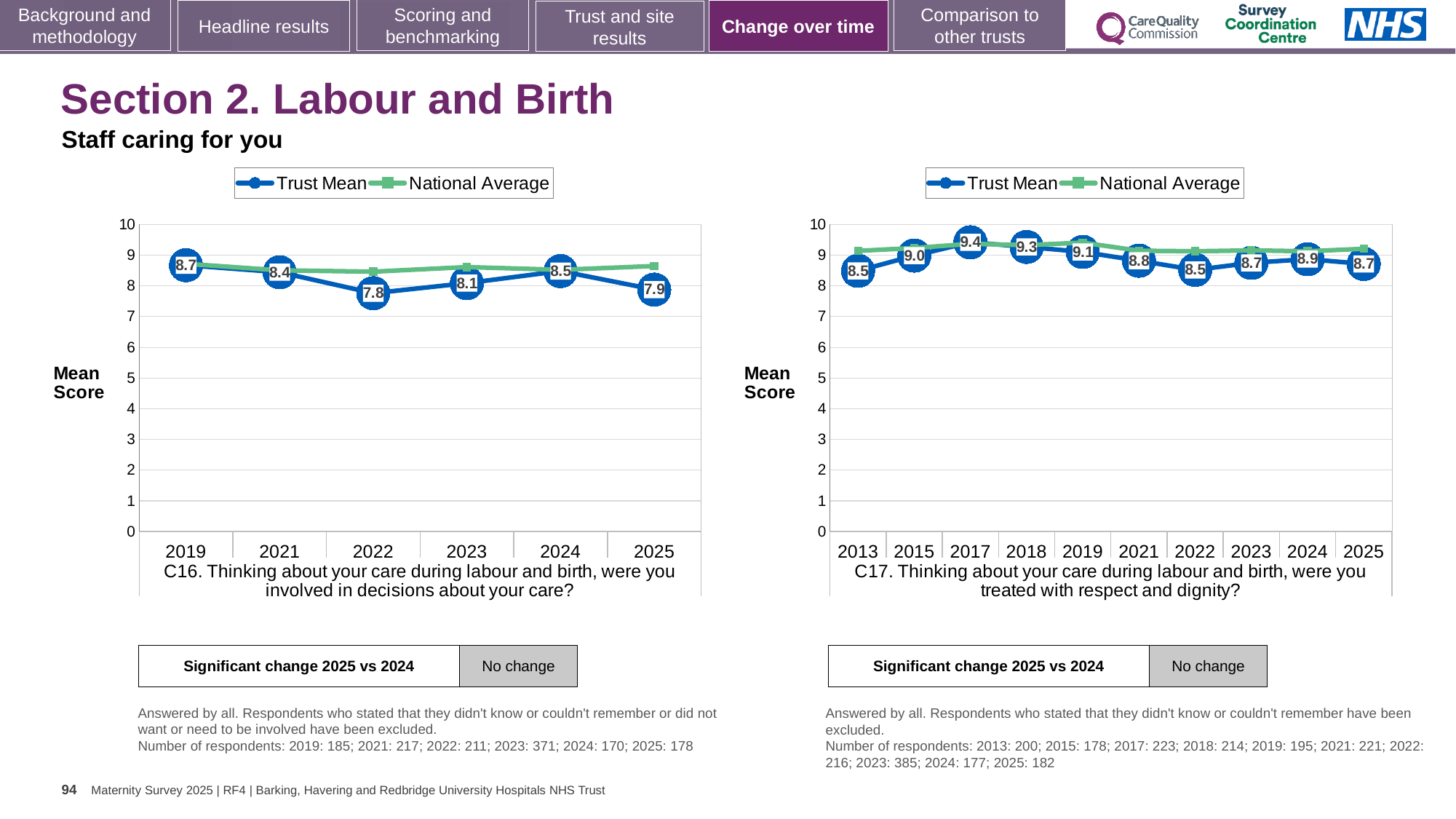
In the C17 chart (right), what is the Trust Mean for 2017? 9.4 In the C16 chart (left), how many years are shown on the x axis? 6 In the C17 chart (right), is the Trust Mean for 2015 or 2022 larger? 2015 In the C17 chart (right), how many series does the legend list? 2 In the C16 chart (left), which year has the highest Trust Mean? 2019 In the C16 chart (left), what is the Trust Mean for 2022? 7.8 In the C16 chart (left), which year has the lowest Trust Mean? 2022 What type of chart is the C16 chart on the left? Line chart In the C16 chart (left), what is the difference between the Trust Mean for 2019 and 2022? 0.9 In the C17 chart (right), which year has the highest Trust Mean? 2017 In the C16 chart (left), what is the Trust Mean for 2025? 7.9 In the C17 chart (right), what is the difference between the Trust Mean for 2024 and 2025? 0.2